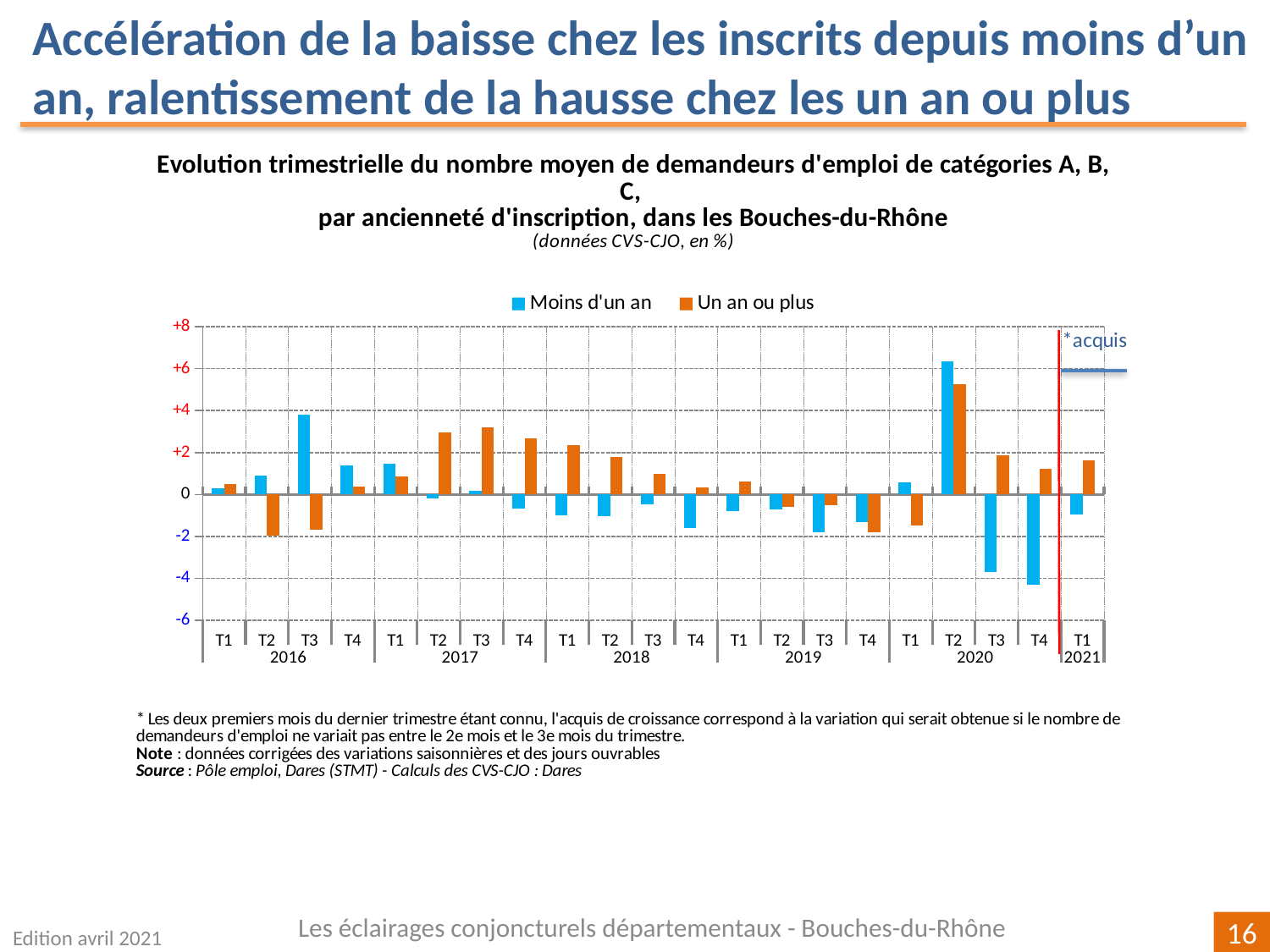
Is the value for 'Moins d'un an' in T2 2020 greater or less than +4? greater In which quarter is the value for 'Un an ou plus' highest? T2 2020 In which quarter is the value for 'Moins d'un an' highest? T2 2020 Is the value for 'Un an ou plus' in T3 2017 greater or less than +2? greater In T3 2017, which series has the larger value, 'Moins d'un an' or 'Un an ou plus'? Un an ou plus Is the value for 'Moins d'un an' in T4 2020 greater or less than -2? less In which quarter is the value for 'Moins d'un an' lowest? T4 2020 What kind of chart is shown on the slide? bar chart How many series does the legend list? 2 Which colour represents the 'Un an ou plus' series? orange How many quarters are plotted along the x axis? 21 What are the two series named in the legend? Moins d'un an; Un an ou plus